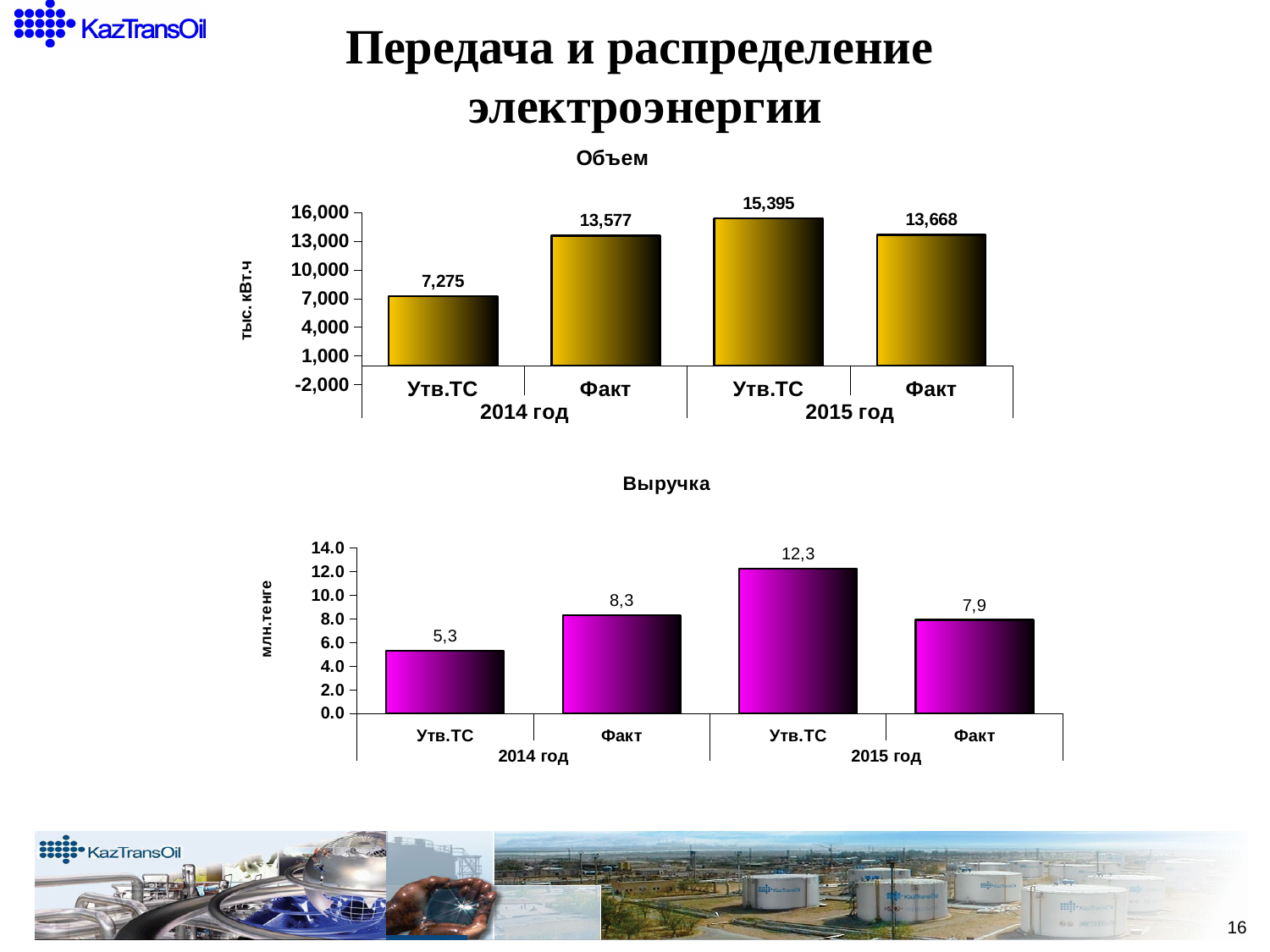
In the "Выручка" chart, which is larger: Факт 2014 год or Факт 2015 год? Факт 2014 год In the "Выручка" chart, what is the value for Утв.ТС in 2015 год? 12,3 In the "Объем" chart, what is the value for Утв.ТС in 2014 год? 7,275 What unit is shown on the y axis of the "Объем" chart? тыс. кВт.ч In the "Объем" chart, which bar has the lowest value? Утв.ТС 2014 год In the "Объем" chart, how many bars are plotted? 4 In the "Объем" chart, what is the difference between Утв.ТС and Факт for 2015 год? 1,727 In the "Выручка" chart, what is the value for Факт in 2014 год? 8,3 What type of chart is the "Выручка" chart? Bar chart In the "Объем" chart, which bar has the highest value? Утв.ТС 2015 год In the "Выручка" chart, which bar has the lowest value? Утв.ТС 2014 год In the "Объем" chart, what is the value for Факт in 2015 год? 13,668